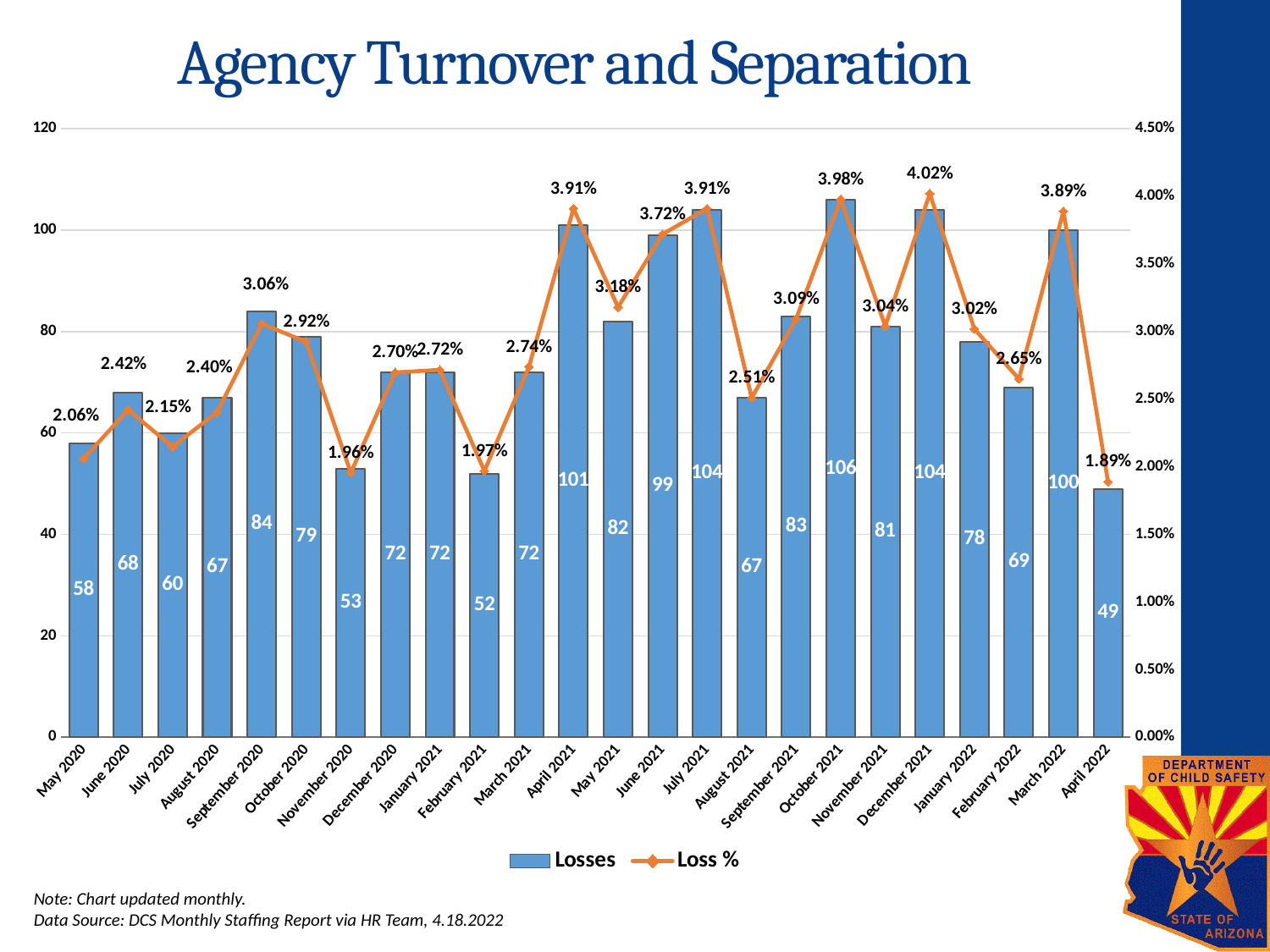
How many series does the legend list? 2 What is the Loss % for September 2020? 3.06% What kind of chart is used to show the Losses series? Bar chart What is the difference in Losses between March 2022 and April 2022? 51 How many months are shown on the x axis? 24 What is the title of the chart? Agency Turnover and Separation What is the Losses value for February 2021? 52 What is the Losses value for October 2021? 106 Which month has the lowest Loss %? April 2022 Which month has the highest Loss %? December 2021 Which month has the highest Losses value? October 2021 Which has a higher Losses value, September 2020 or October 2020? September 2020